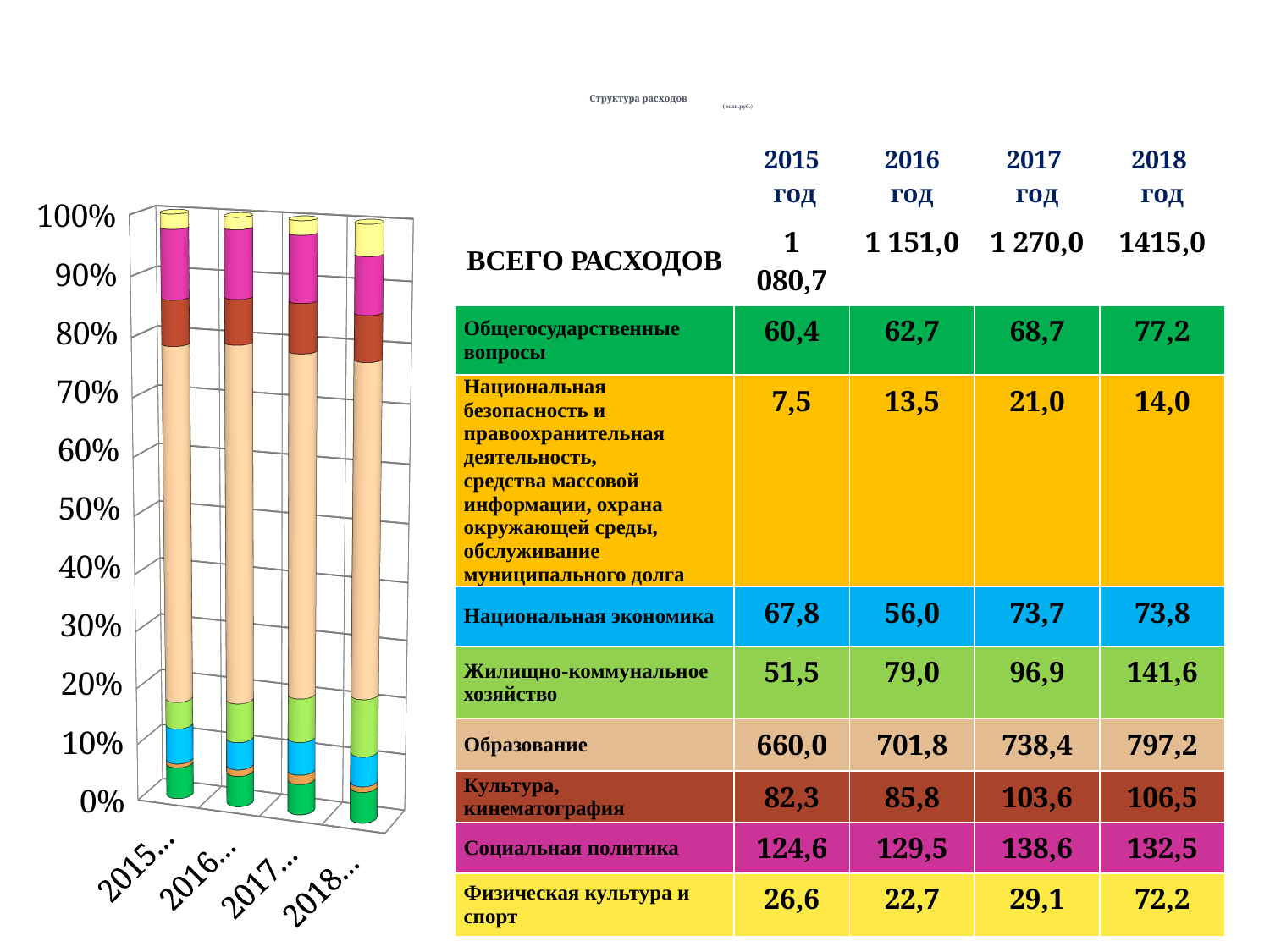
How many year categories are plotted along the x axis of the bar chart? 4 Which is larger, the Национальная экономика value for 2016 год or for 2017 год? 2017 год Do the Образование values rise or fall from 2015 год to 2018 год? rise What kind of chart is shown on the left of the slide? bar chart According to the table, what is the value for Образование in 2018 год? 797,2 In the bar chart, is the top of the tan (Образование) segment for 2015 above or below the 70% gridline? above In which year is the value for Физическая культура и спорт lowest? 2016 год According to the table, what is ВСЕГО РАСХОДОВ for 2017 год? 1 270,0 What is the difference between the Образование values for 2018 год and 2015 год? 137,2 How many expense categories (coloured rows) are listed in the table below ВСЕГО РАСХОДОВ? 8 According to the table, what is the value for Социальная политика in 2017 год? 138,6 In which year is the value for Жилищно-коммунальное хозяйство highest? 2018 год